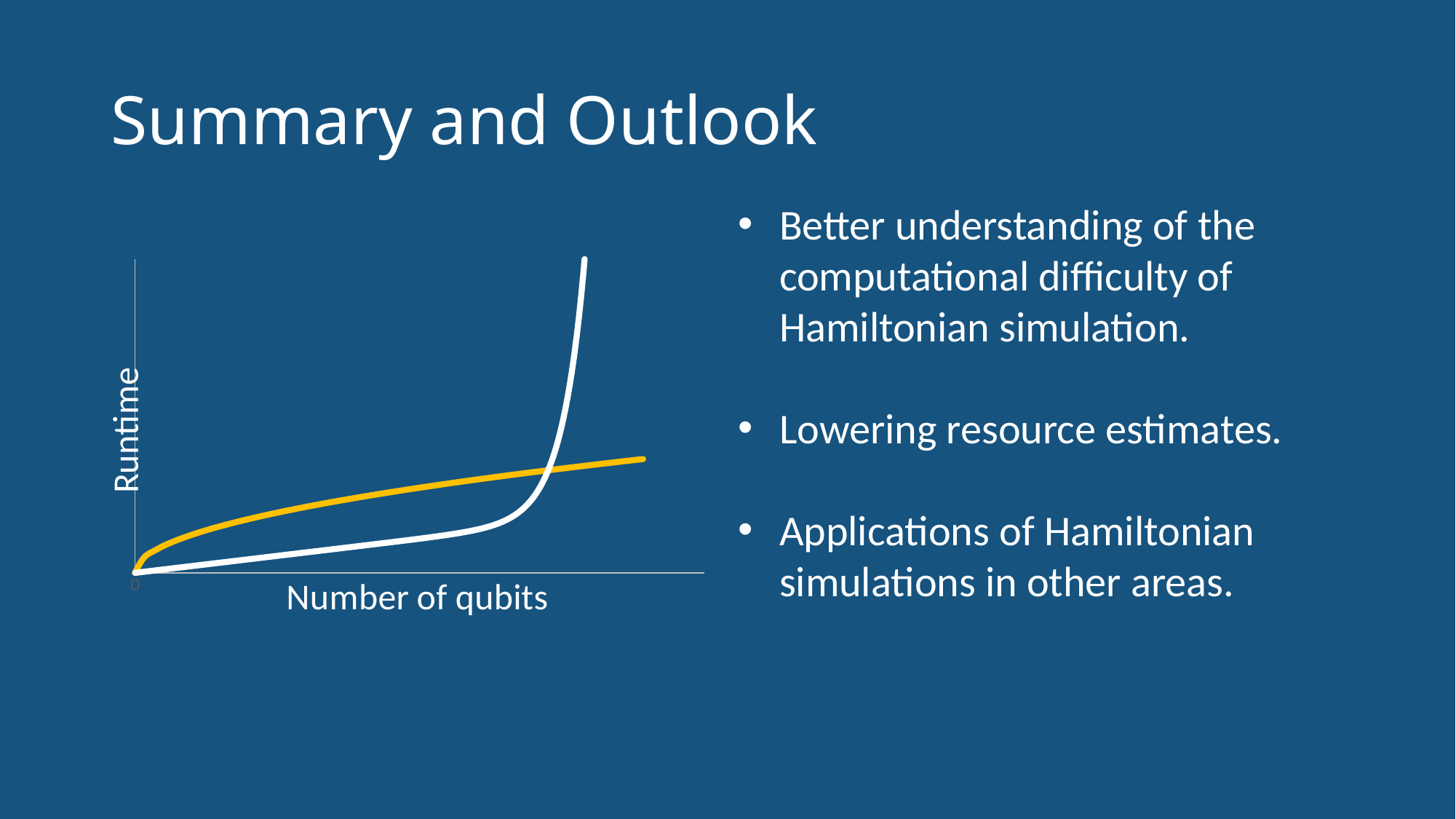
What is the only numeric tick value printed on the chart's axes? 0 How many lines are plotted on the chart? 2 Does the yellow line rise or fall as the number of qubits increases? rise Which line grows more steeply at large numbers of qubits, the white line or the yellow line? the white line What kind of chart is shown on the slide? line chart Which line shows the higher runtime for small numbers of qubits, the white line or the yellow line? the yellow line What is the label of the horizontal axis of the chart? Number of qubits Which line reaches the highest runtime at the right end of the chart, the white line or the yellow line? the white line Does the white line rise or fall as the number of qubits increases? rise What is the label of the vertical axis of the chart? Runtime